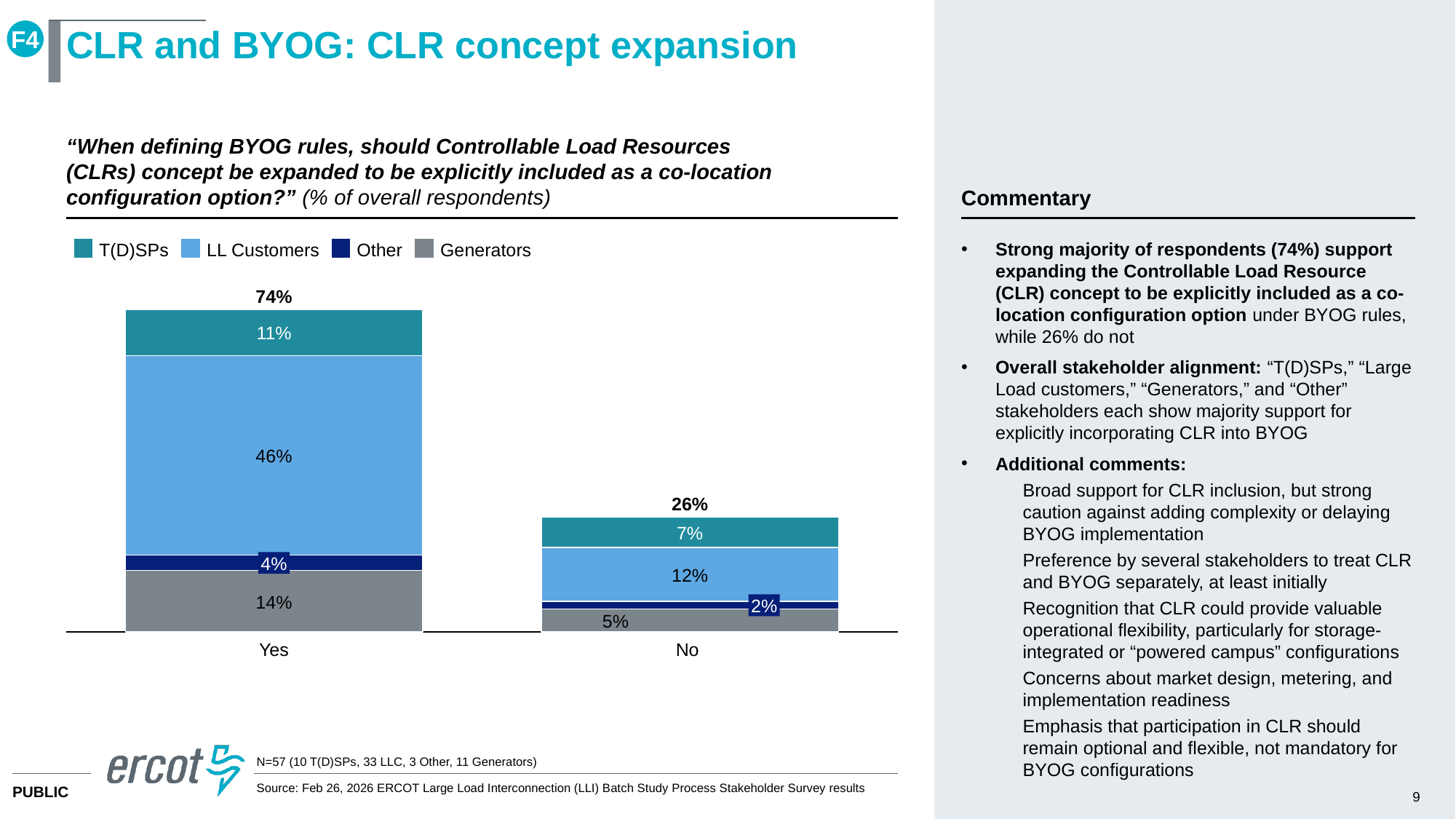
What is the total for the No bar? 26% What is the value for LL Customers in the Yes bar? 46% Which category has the higher total, Yes or No? Yes What is the value for Other in the No bar? 2% How many categories are shown on the x axis? 2 What is the value for T(D)SPs in the Yes bar? 11% What is the total for the Yes bar? 74% How many series does the legend list? 4 What is the difference between the LL Customers values for Yes and No? 34% What kind of chart is shown on the slide? Stacked bar chart What is the value for Generators in the No bar? 5% Which is larger, the Generators value for Yes or the T(D)SPs value for No? Generators value for Yes